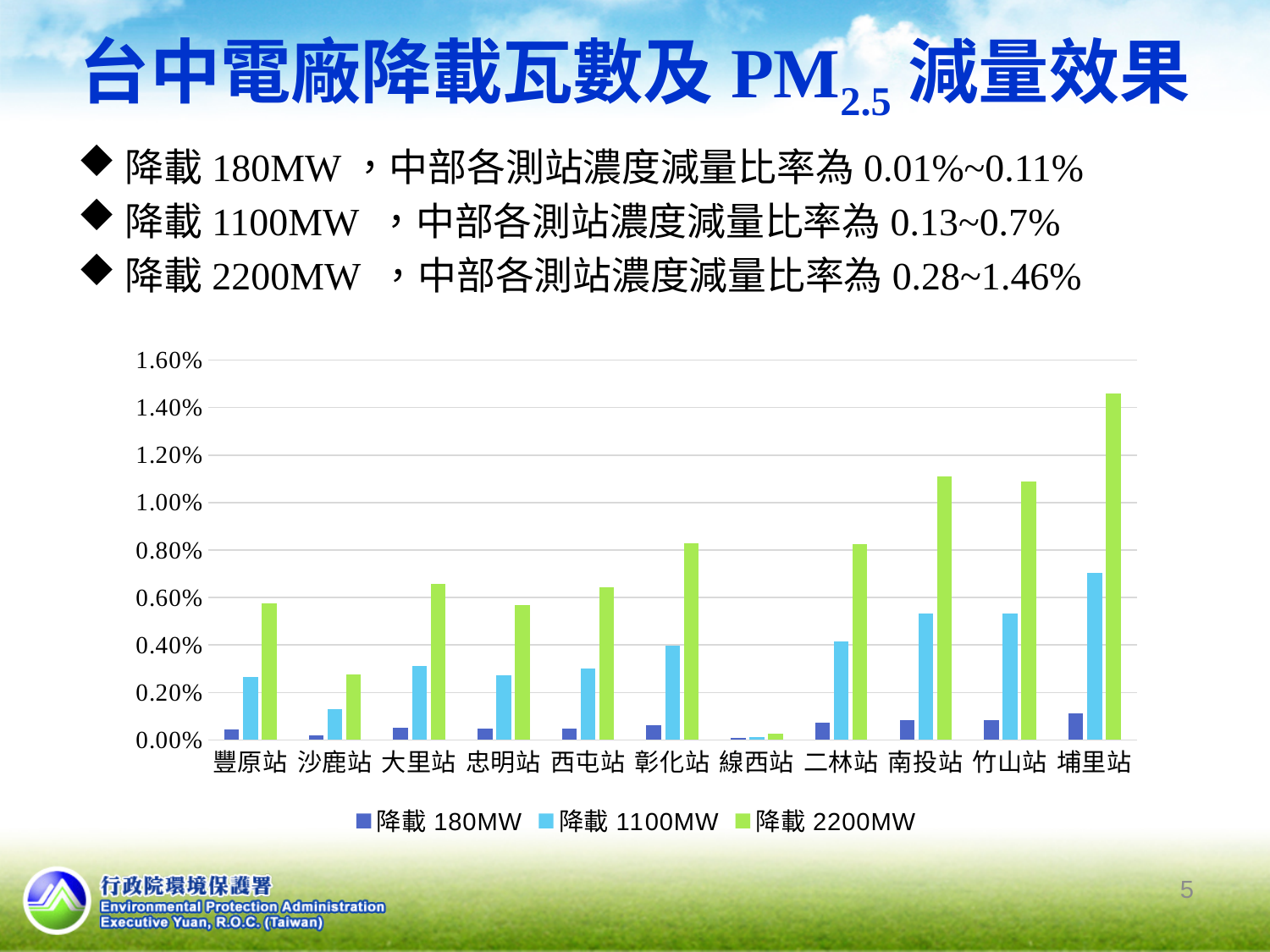
Is the 降載 2200MW value for 南投站 greater or less than 1.00%? greater Which station has the lowest value for the 降載 2200MW series? 線西站 For the 降載 2200MW series, which is larger: 豐原站 or 沙鹿站? 豐原站 What kind of chart is shown on the slide? bar chart How many monitoring stations (categories) are shown on the x axis of the chart? 11 How many series does the chart legend list? 3 Is the 降載 2200MW value for 線西站 greater or less than 0.20%? less Which series is shown in green in the chart legend? 降載 2200MW Which station has the highest value for the 降載 2200MW series? 埔里站 Is the 降載 2200MW value for 埔里站 greater or less than 1.20%? greater Which station has the highest value for the 降載 1100MW series? 埔里站